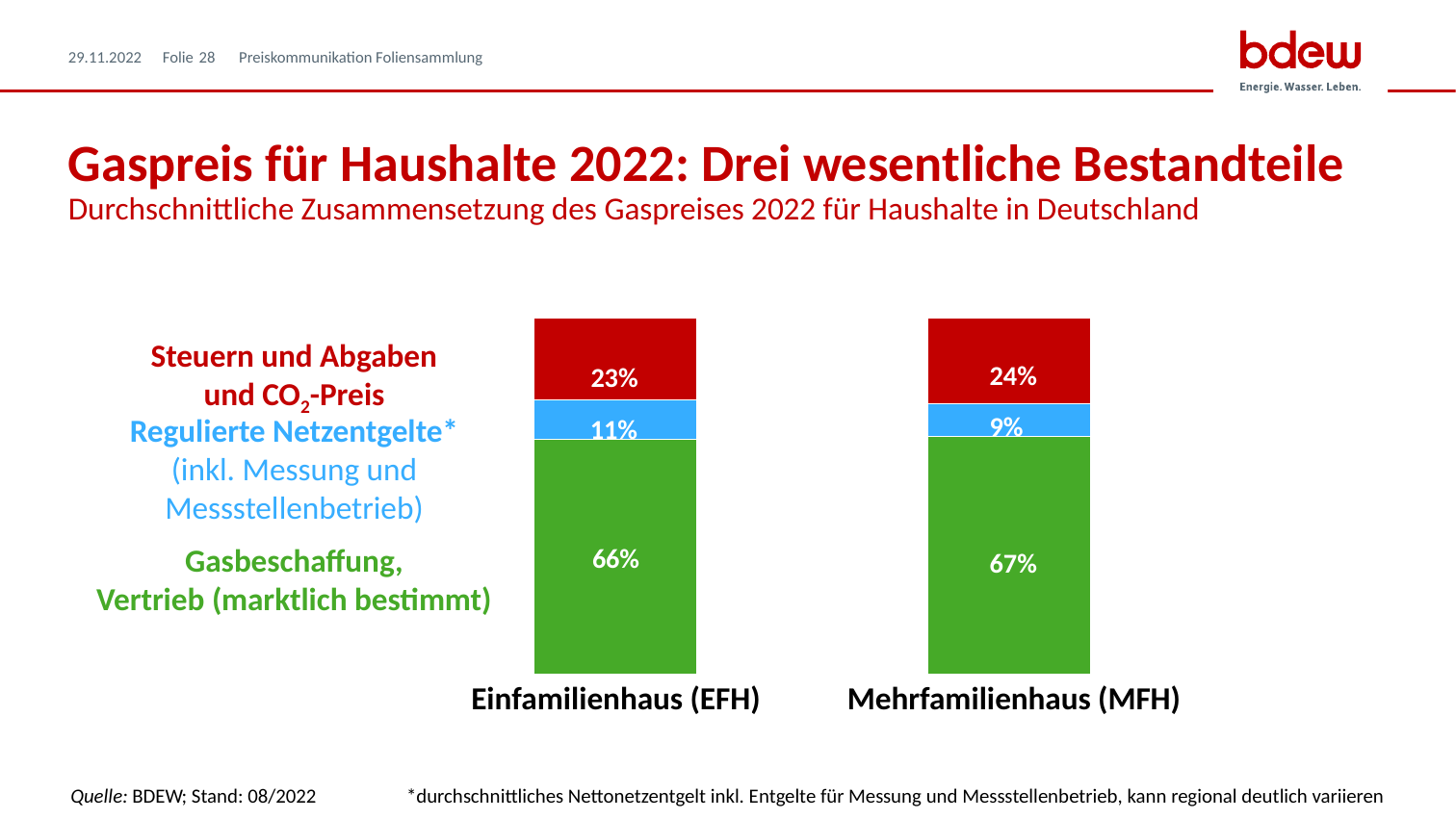
Which component makes up the smallest share of the gas price for Einfamilienhaus (EFH)? Regulierte Netzentgelte What is the difference between the Regulierte Netzentgelte share for Einfamilienhaus (EFH) and for Mehrfamilienhaus (MFH)? 2 percentage points What kind of chart is shown on the slide? Stacked bar chart What share of the gas price for Einfamilienhaus (EFH) is Gasbeschaffung, Vertrieb (marktlich bestimmt)? 66% Is the Steuern und Abgaben und CO2-Preis share larger for Einfamilienhaus (EFH) or for Mehrfamilienhaus (MFH)? Mehrfamilienhaus (MFH) What share of the gas price for Mehrfamilienhaus (MFH) is Regulierte Netzentgelte? 9% Which component makes up the largest share of the gas price for Mehrfamilienhaus (MFH)? Gasbeschaffung, Vertrieb (marktlich bestimmt) How many price components are stacked in each bar? 3 How many household categories are shown in the chart? 2 What is the total of the three components in the Einfamilienhaus (EFH) bar? 100% What share of the gas price for Einfamilienhaus (EFH) is Regulierte Netzentgelte? 11% What share of the gas price for Mehrfamilienhaus (MFH) is Steuern und Abgaben und CO2-Preis? 24%